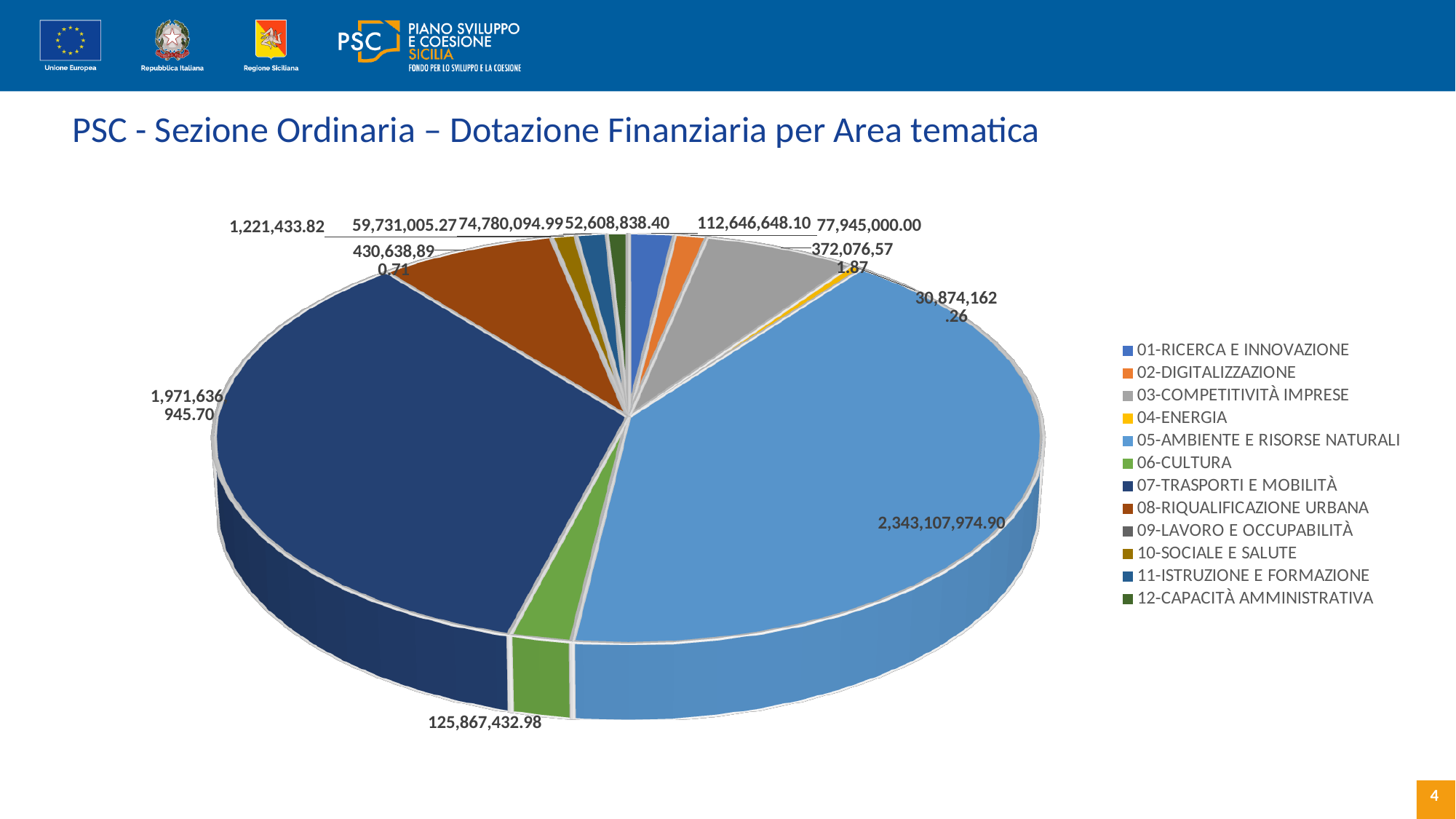
What is the title of the slide containing the pie chart? PSC - Sezione Ordinaria – Dotazione Finanziaria per Area tematica Which category has the smallest slice in the pie chart? 09-LAVORO E OCCUPABILITÀ What is the value shown for 07-TRASPORTI E MOBILITÀ? 1,971,636,945.70 What is the value shown for 05-AMBIENTE E RISORSE NATURALI? 2,343,107,974.90 Which is larger, the value for 07-TRASPORTI E MOBILITÀ or the value for 08-RIQUALIFICAZIONE URBANA? 07-TRASPORTI E MOBILITÀ What is the value shown for 01-RICERCA E INNOVAZIONE? 112,646,648.10 Which category has the largest slice in the pie chart? 05-AMBIENTE E RISORSE NATURALI What kind of chart is shown on the slide? Pie chart How many categories (slices) does the pie chart have? 12 What is the difference between the values for 05-AMBIENTE E RISORSE NATURALI and 07-TRASPORTI E MOBILITÀ? 371,471,029.20 What is the value shown for 02-DIGITALIZZAZIONE? 77,945,000.00 What is the value shown for 06-CULTURA? 125,867,432.98